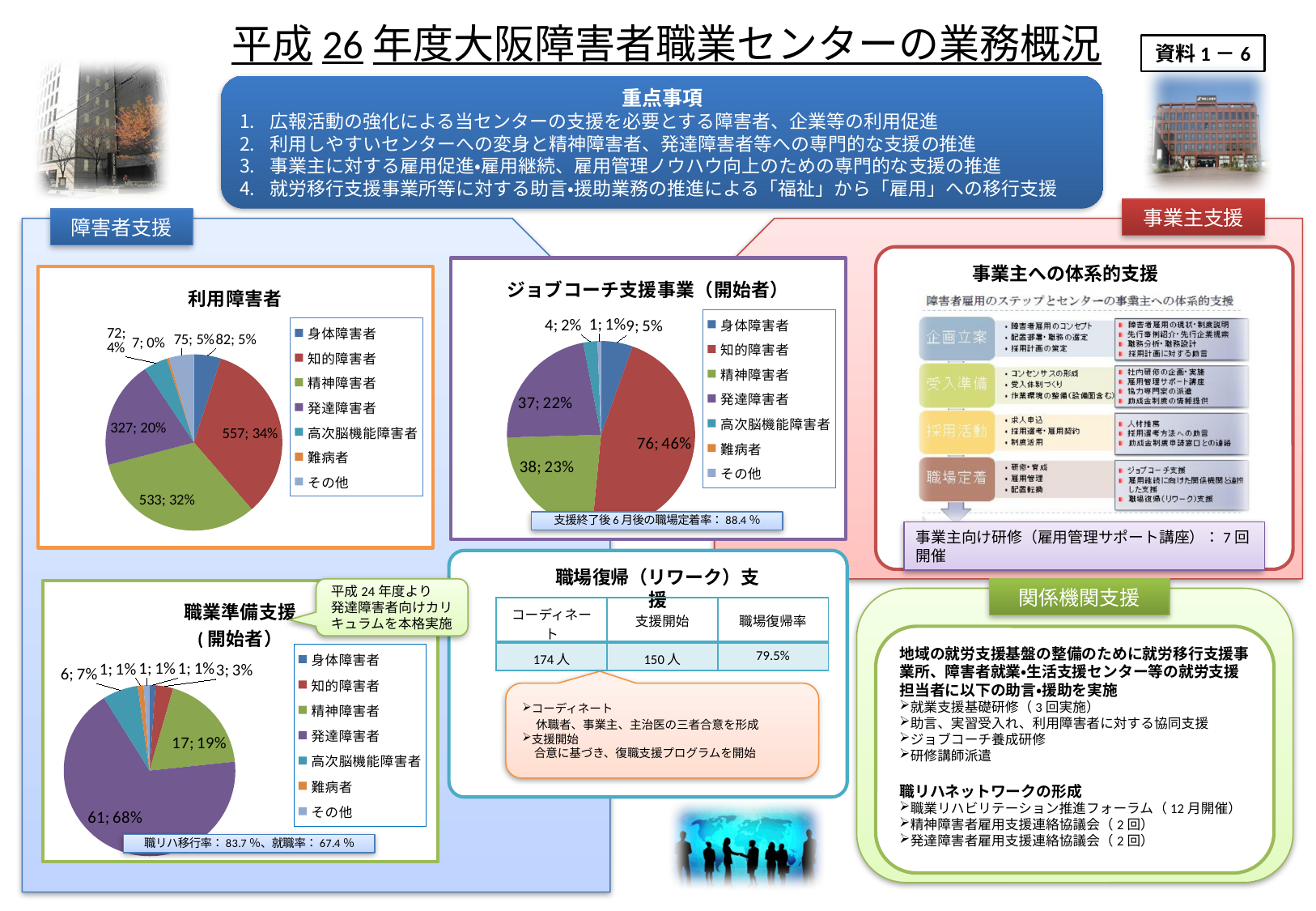
In the 利用障害者 pie chart, which category has the smallest slice? 難病者 In the ジョブコーチ支援事業（開始者） pie chart, what share of the pie does 発達障害者 have? 22% In the ジョブコーチ支援事業（開始者） pie chart, which is larger, 精神障害者 or 発達障害者? 精神障害者 In the ジョブコーチ支援事業（開始者） pie chart, what is the value and share for 知的障害者? 76; 46% In the 職業準備支援（開始者） pie chart, what is the difference between the values for 発達障害者 and 精神障害者? 44 In the 利用障害者 pie chart, what is the value and share for 精神障害者? 533; 32% How many entries does the legend of the 利用障害者 pie chart list? 7 What type of chart is used for 職業準備支援（開始者）? Pie chart In the 利用障害者 pie chart, what is the difference between the values for 知的障害者 and 発達障害者? 230 In the 職業準備支援（開始者） pie chart, what is the value and share for 発達障害者? 61; 68% In the 利用障害者 pie chart, what is the value and share for 知的障害者? 557; 34% In the 利用障害者 pie chart, which category has the largest slice? 知的障害者